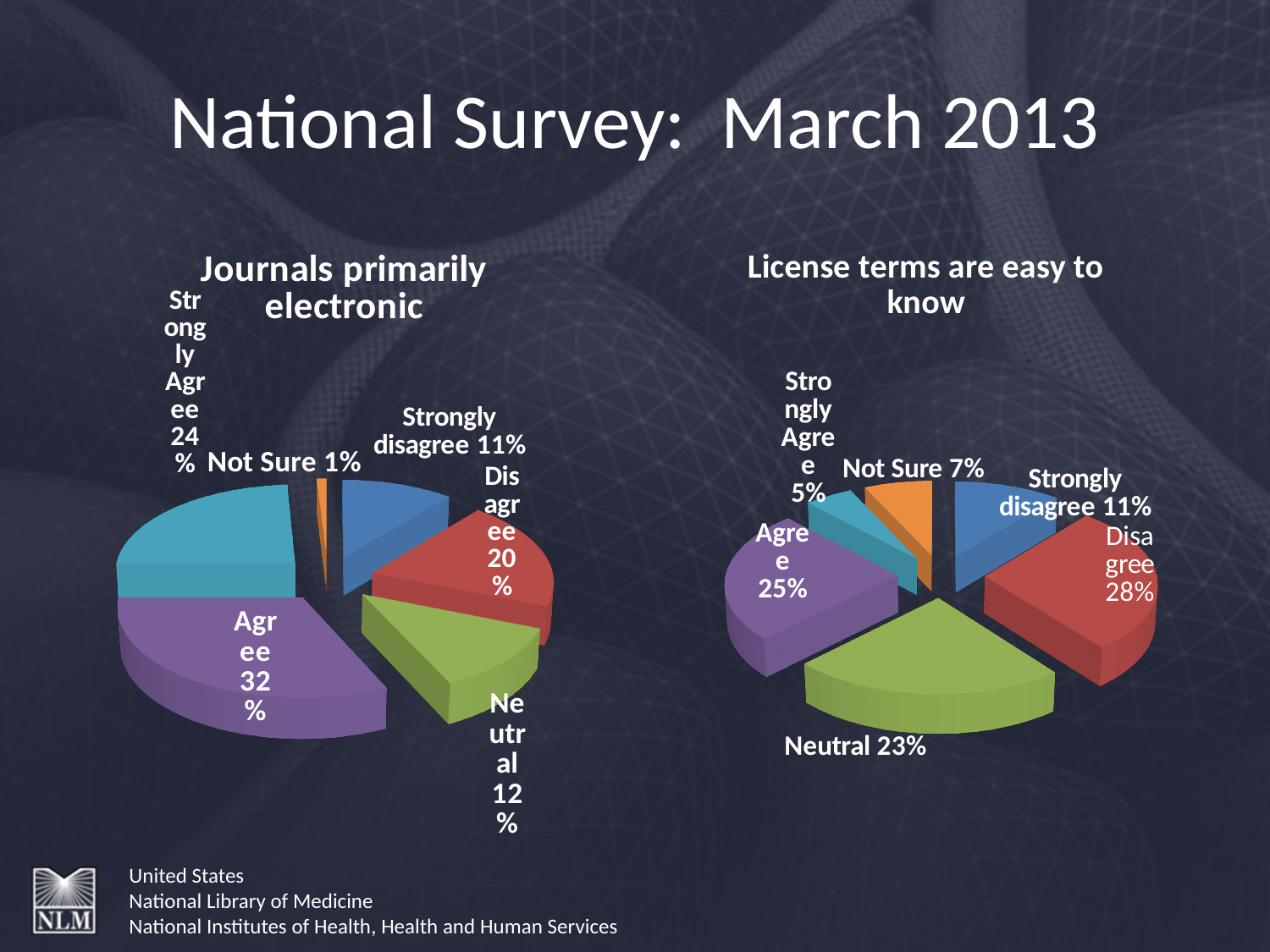
In the 'Journals primarily electronic' chart, what percentage of respondents chose Agree? 32% In the 'License terms are easy to know' chart, which is larger, the Neutral share or the Agree share? Agree In the 'Journals primarily electronic' chart, which response has the smallest share? Not Sure In the 'License terms are easy to know' chart, which response has the largest share? Disagree What type of chart is used for 'Journals primarily electronic'? Pie chart In the 'License terms are easy to know' chart, what percentage of respondents chose Not Sure? 7% In the 'Journals primarily electronic' chart, what is the difference between the Agree and Disagree percentages? 12% In the 'License terms are easy to know' chart, what percentage of respondents chose Disagree? 28% How many slices does the 'License terms are easy to know' chart have? 6 In the 'Journals primarily electronic' chart, what percentage of respondents chose Strongly Agree? 24% In the 'Journals primarily electronic' chart, which response has the largest share? Agree In the 'License terms are easy to know' chart, which response has the smallest share? Strongly Agree